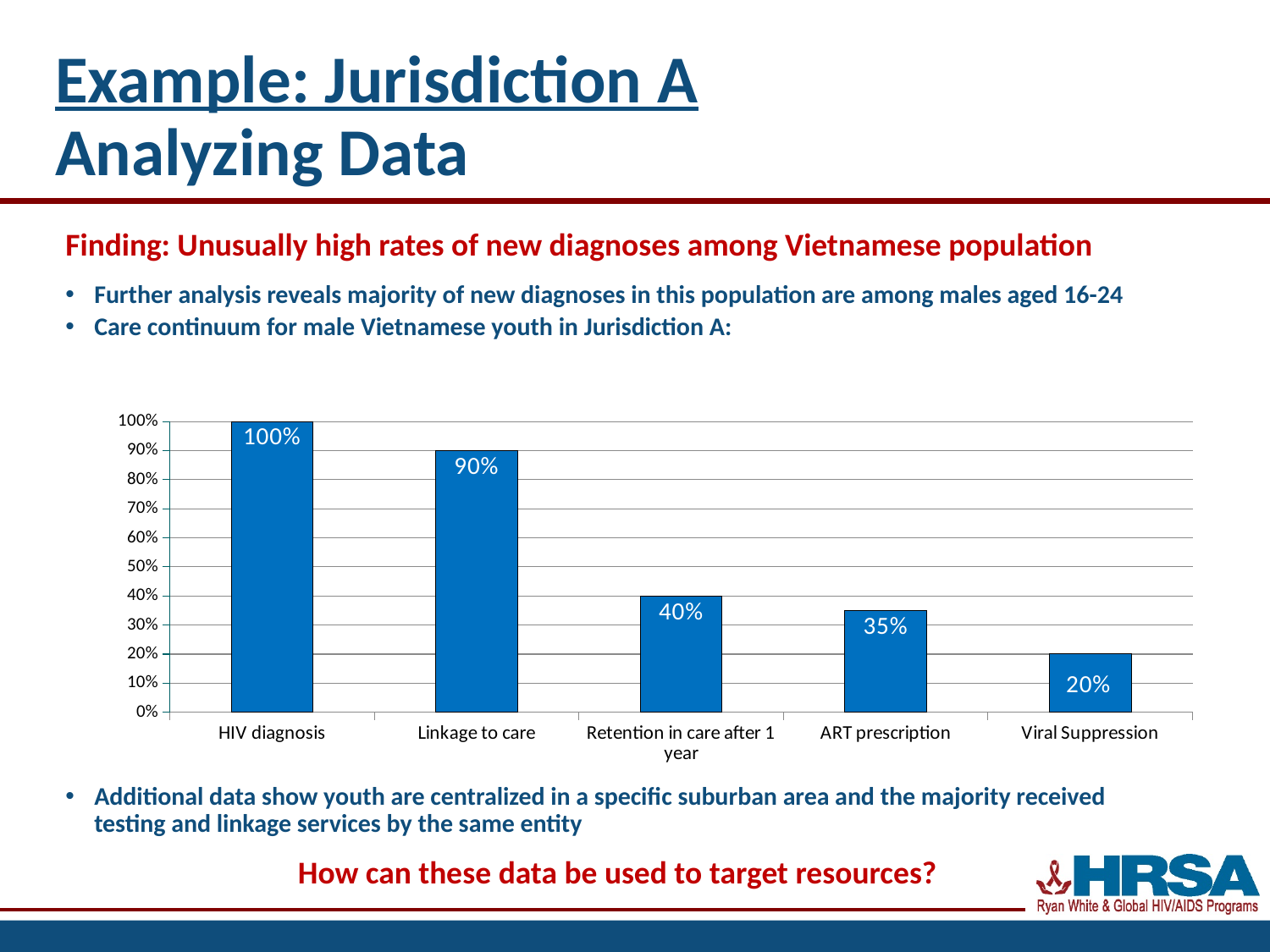
What kind of chart is shown on the slide? Bar chart What is the difference between the values for ART prescription and Viral Suppression? 15% What is the difference between the values for Linkage to care and Retention in care after 1 year? 50% Do the values rise or fall from left to right along the x axis? Fall How many categories are shown on the x axis? 5 Which category has the highest value? HIV diagnosis Which category has the lowest value? Viral Suppression What is the value for Viral Suppression? 20% What is the value for ART prescription? 35% What is the value for Retention in care after 1 year? 40% Which is larger, the value for Retention in care after 1 year or the value for ART prescription? Retention in care after 1 year What is the value for Linkage to care? 90%